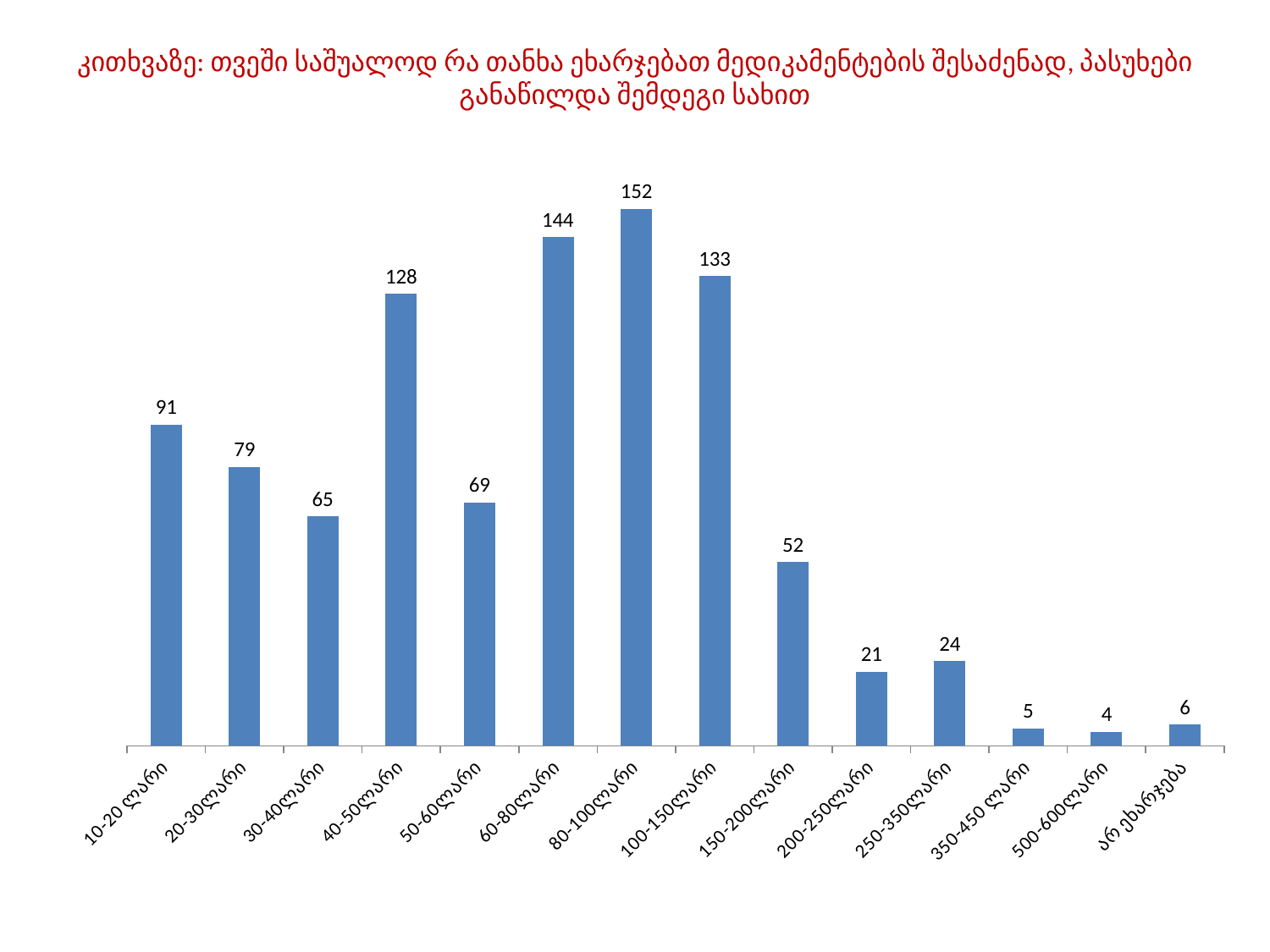
What is the value for the არ ეხარჯება category? 6 Which category has the highest value? 80-100ლარი What is the value for the 200-250ლარი category? 21 What is the value for the 80-100ლარი category? 152 Which category has the lowest value? 500-600ლარი What is the difference between the values for 10-20 ლარი and 30-40ლარი? 26 How many categories are shown on the x axis? 14 Do the values rise or fall from 100-150ლარი to 350-450 ლარი along the x axis? Fall What is the value for the 40-50ლარი category? 128 What kind of chart is shown on the slide? Bar chart What is the difference between the values for 60-80ლარი and 100-150ლარი? 11 Which is larger, the value for 20-30ლარი or the value for 50-60ლარი? 20-30ლარი